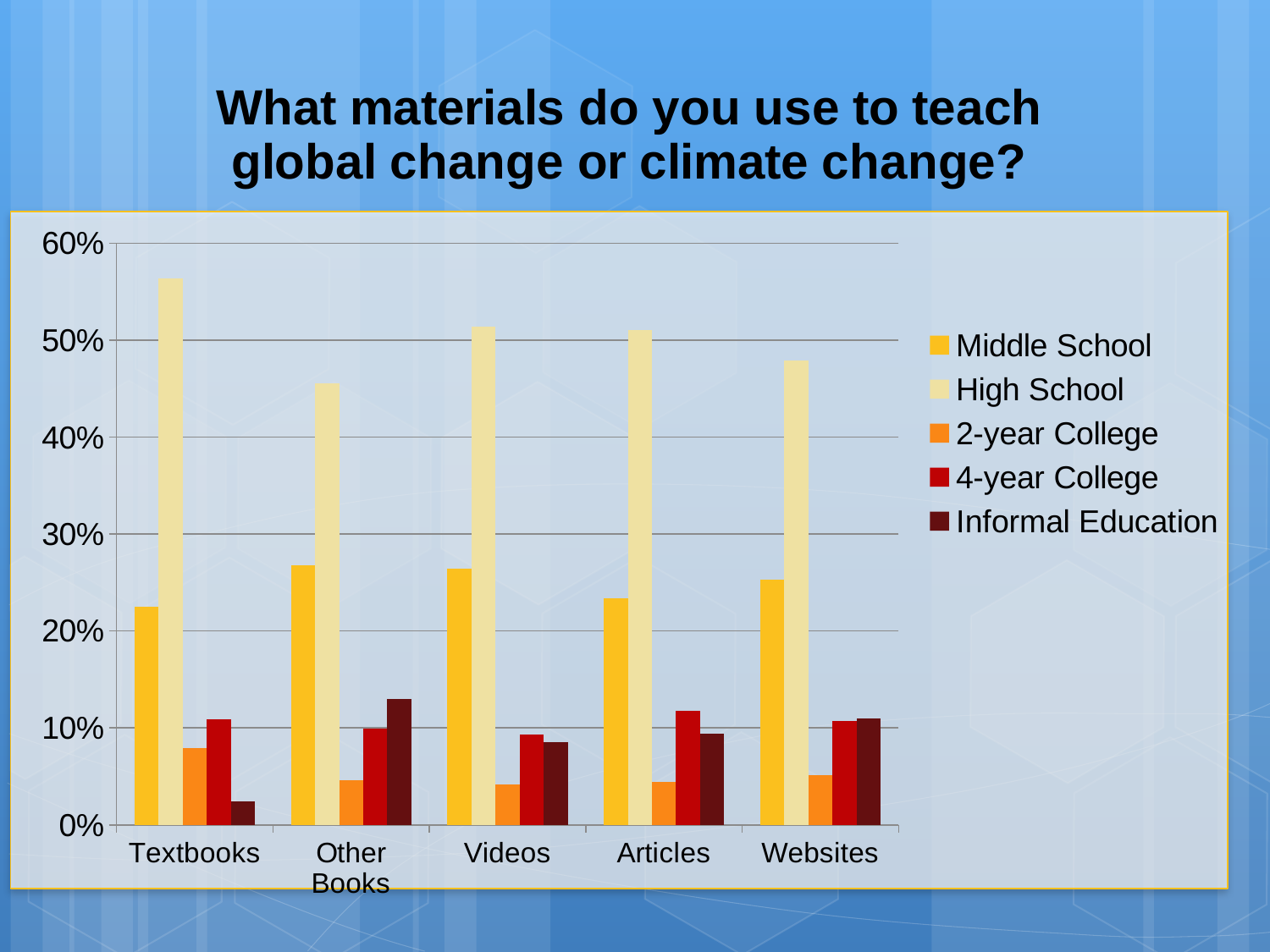
How many material categories are shown on the x axis? 5 For which material is the Informal Education value lowest? Textbooks Is the Middle School value for Textbooks greater or less than 30%? less For Other Books, which is larger: the Informal Education value or the 2-year College value? Informal Education How many series does the legend list? 5 For Videos, which is larger: the High School value or the Middle School value? High School What kind of chart is shown on the slide? bar chart Is the High School value for Textbooks greater or less than 50%? greater For which material is the High School value lowest? Other Books Is the High School value for Other Books greater or less than 50%? less For which material is the High School value highest? Textbooks